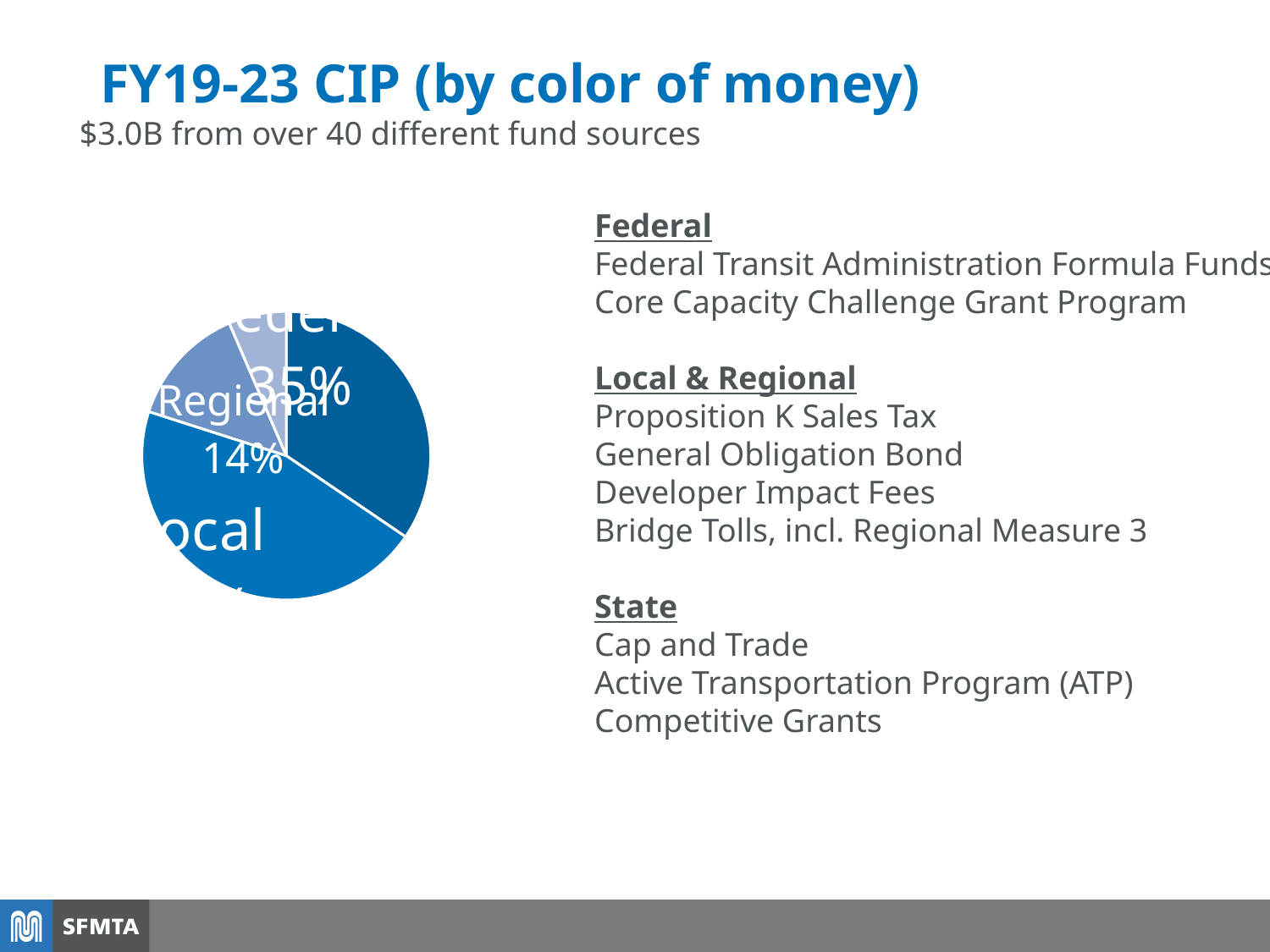
According to the subtitle, how much funding comes from over 40 different fund sources? $3.0B What percentage of the pie is labeled for Federal? 35% What is the title of the slide containing the pie chart? FY19-23 CIP (by color of money) Which is larger in the pie chart, the Federal slice or the Regional slice? Federal What kind of chart is shown on the slide? pie chart By how many percentage points does the Federal share exceed the Regional share? 21% Which is larger in the pie chart, the Local slice or the Federal slice? Local Which slice of the pie chart is the largest? Local What percentage of the pie is labeled for Regional? 14%